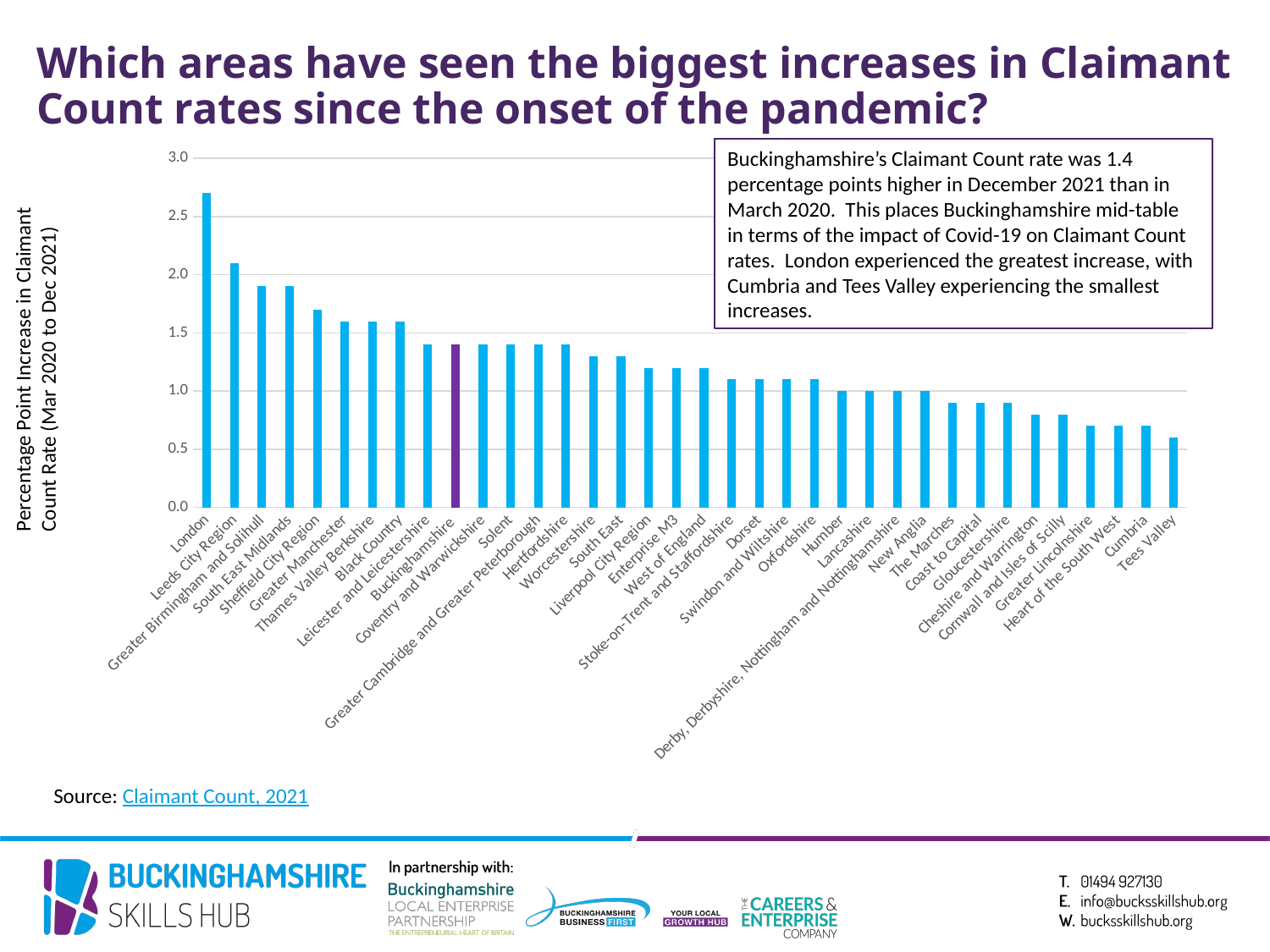
Which has a larger increase, Buckinghamshire or Cumbria? Buckinghamshire What type of chart is shown on the slide? Bar chart Which area's bar is coloured purple rather than blue? Buckinghamshire Which has a larger increase, London or Leeds City Region? London Which area has the highest percentage point increase in Claimant Count rate? London Is the value for London greater or less than 2.5? greater Which area has the lowest percentage point increase in Claimant Count rate? Tees Valley Is the value for Solent greater or less than 1.5? less What is the percentage point increase in Claimant Count rate for Buckinghamshire? 1.4 Do the bar values rise or fall from left to right along the x axis? Fall Is the value for Tees Valley greater or less than 1.0? less